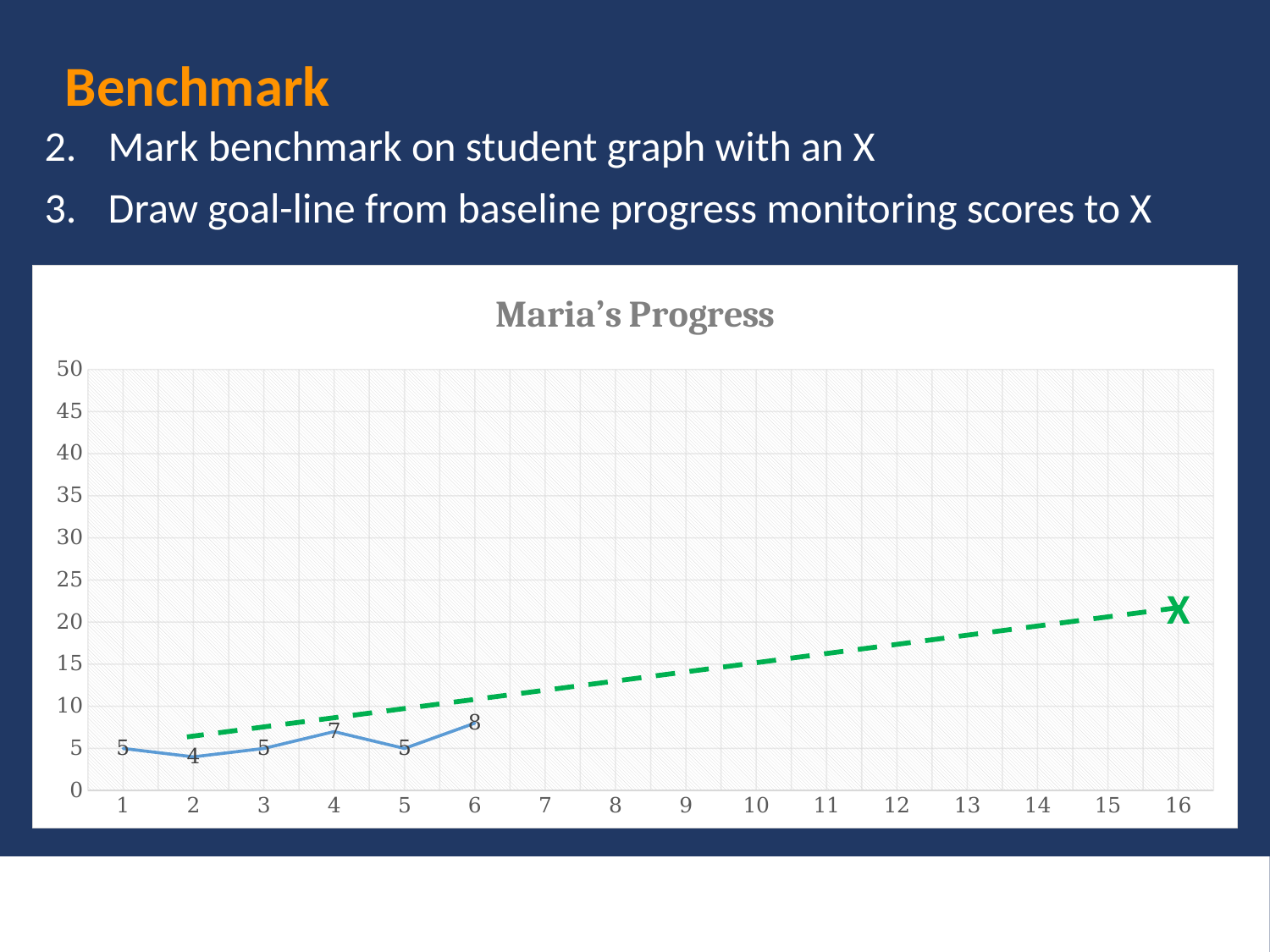
What type of chart is shown on the slide? line chart Is the value where the green dashed goal line ends at the X (point 16) greater or less than 15? greater What is the value plotted at point 6 on the x axis? 8 At which x-axis point is the plotted value lowest? 2 What is the difference between the value at point 6 and the value at point 2? 4 Which is larger, the value at point 4 or the value at point 5? point 4 At which x-axis point is the plotted value highest? 6 What is the value plotted at point 1 on the x axis? 5 How many data points are plotted on the blue line? 6 What is the title of the chart? Maria's Progress What is the value plotted at point 2 on the x axis? 4 What is the value plotted at point 4 on the x axis? 7